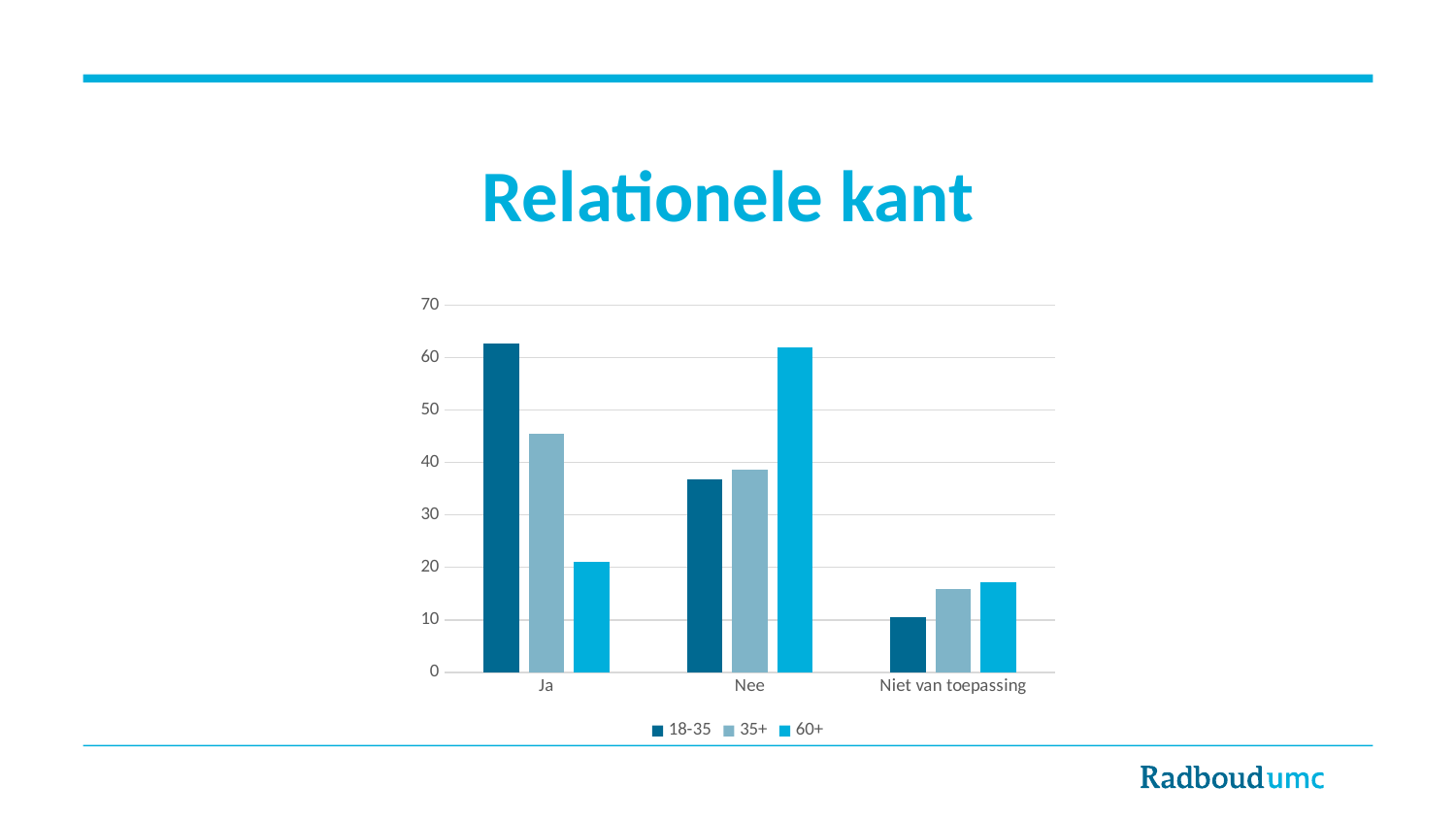
How many categories are shown on the x axis? 3 Which age group has the highest value for the category 'Nee'? 60+ What is the title of the slide with the chart? Relationele kant How many series does the legend list? 3 Is the value for 60+ in the category 'Nee' greater or less than 50? greater Which age group has the lowest value for the category 'Niet van toepassing'? 18-35 Which age group has the lowest value for the category 'Ja'? 60+ Is the value for 18-35 in the category 'Ja' greater or less than 60? greater Which is larger: the value for 35+ in 'Ja' or the value for 35+ in 'Nee'? 35+ in 'Ja' Is the value for 60+ in the category 'Ja' greater or less than 30? less What kind of chart is shown on the slide? bar chart Which age group has the highest value for the category 'Ja'? 18-35